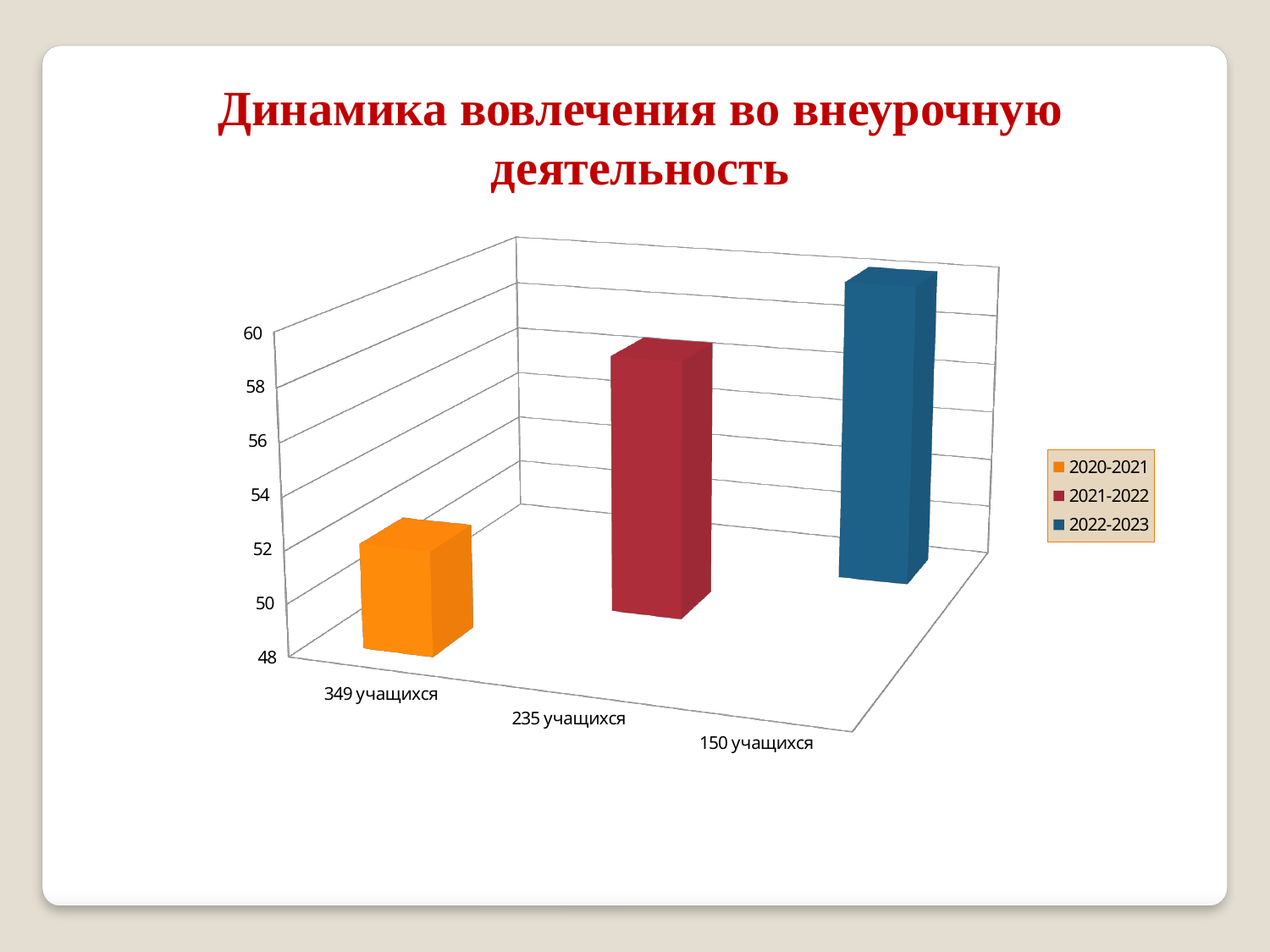
Which is larger, the bar for 2021-2022 or the bar for 2020-2021? 2021-2022 Is the value for the 2020-2021 bar greater or less than 56? less Which series has the highest bar in the chart? 2022-2023 Do the bar values rise or fall from 2020-2021 to 2022-2023? rise Is the value for the 2022-2023 bar greater or less than 56? greater Is the value for the 2021-2022 bar greater or less than 54? greater How many series does the legend list? 3 What kind of chart is shown on the slide? bar chart What is the title of the slide containing the chart? Динамика вовлечения во внеурочную деятельность Which series has the lowest bar in the chart? 2020-2021 How many bars are plotted in the chart? 3